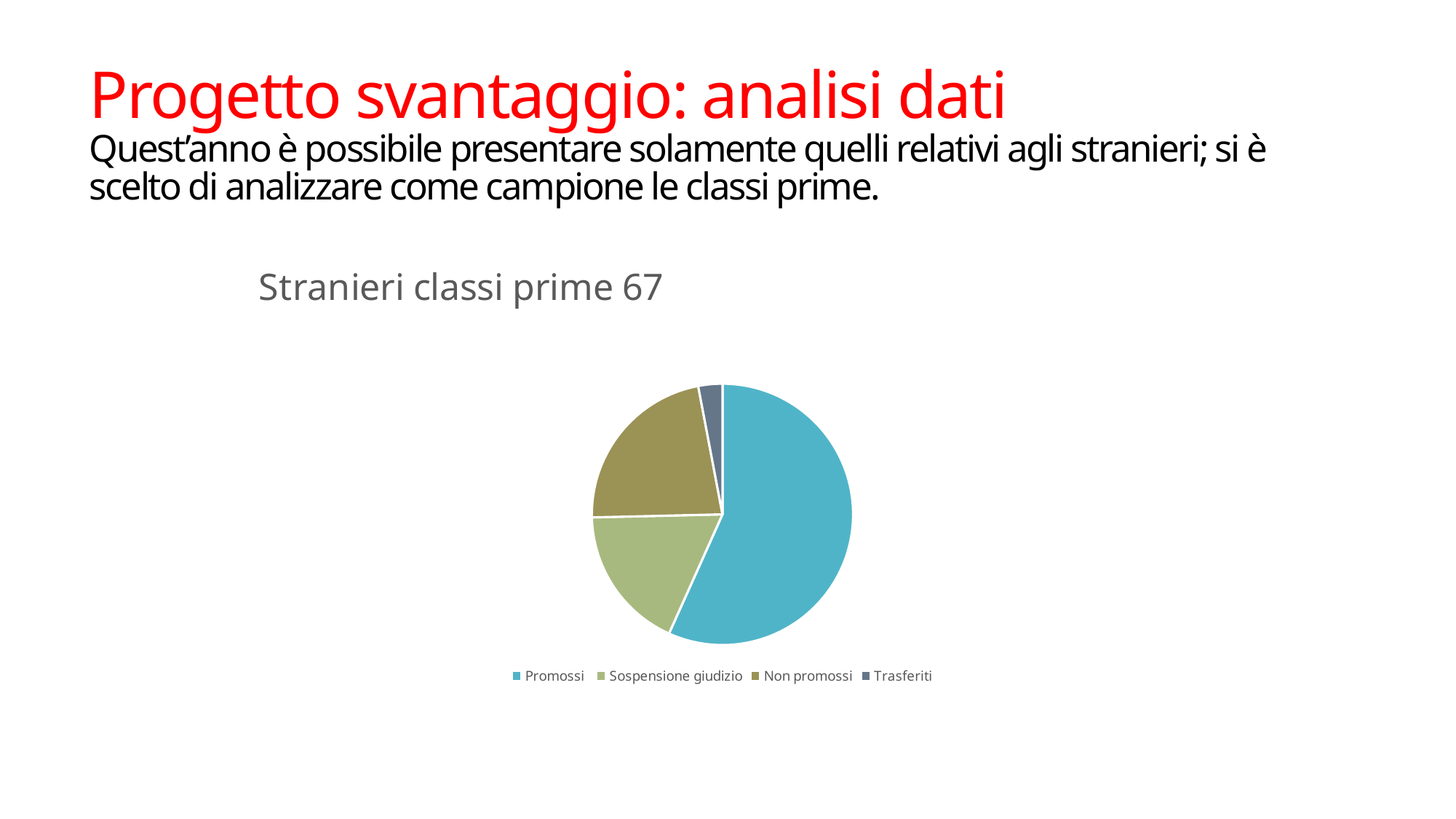
Which category has the largest slice of the pie? Promossi What kind of chart is shown on the slide? pie chart How many entries does the legend list? 4 How many slices does the pie chart have? 4 Which category has the smallest slice of the pie? Trasferiti What is the title of the chart? Stranieri classi prime 67 Which slice is larger, Non promossi or Sospensione giudizio? Non promossi Which slice is larger, Promossi or Non promossi? Promossi Which slice is larger, Sospensione giudizio or Trasferiti? Sospensione giudizio Which category is shown in the blue slice of the pie? Promossi